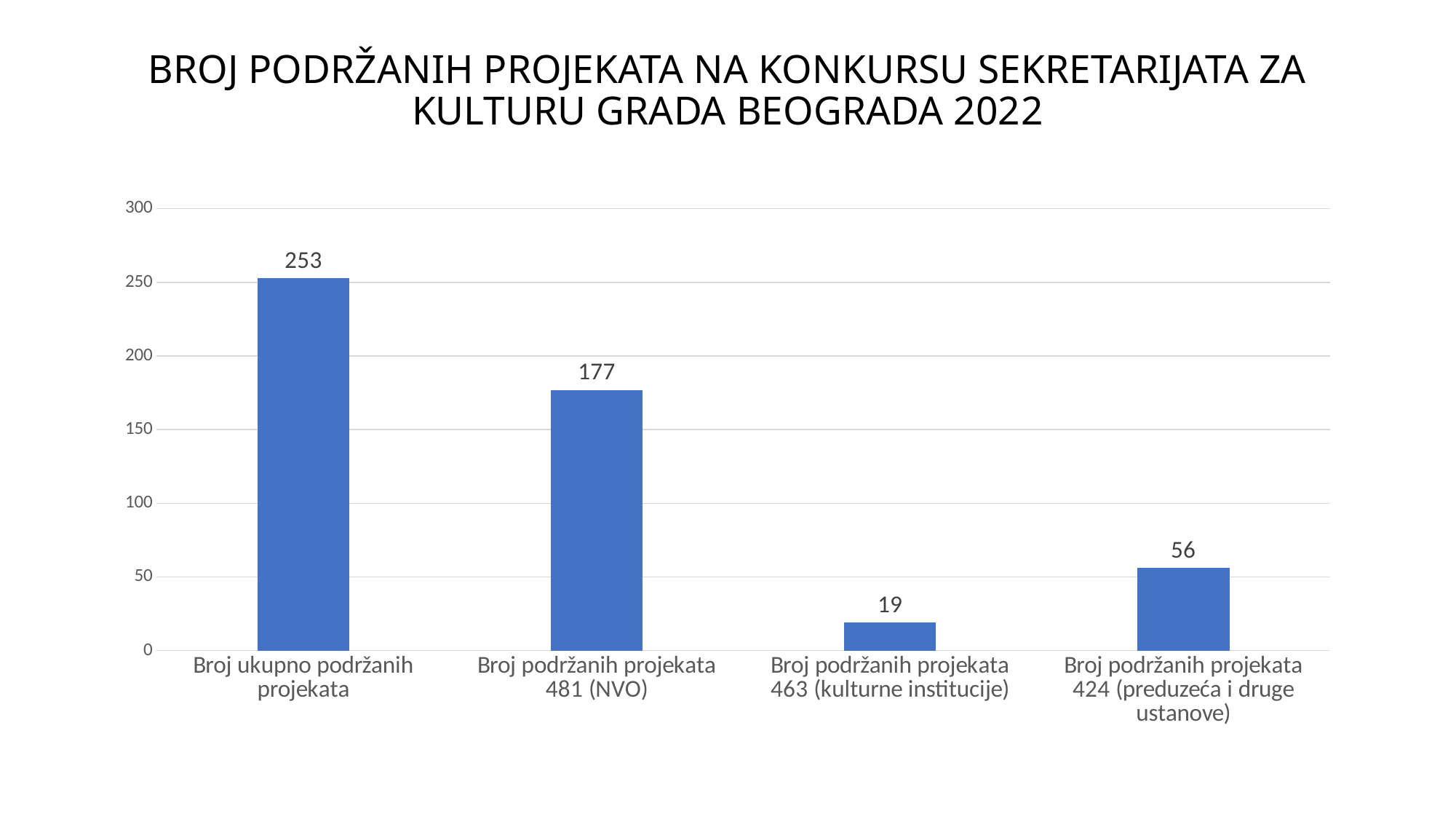
What is the value for 'Broj ukupno podržanih projekata'? 253 Which is larger: the value for 'Broj podržanih projekata 481 (NVO)' or the value for 'Broj podržanih projekata 424 (preduzeća i druge ustanove)'? Broj podržanih projekata 481 (NVO) What is the value for 'Broj podržanih projekata 463 (kulturne institucije)'? 19 What kind of chart is shown on the slide? Bar chart Which category has the lowest value? Broj podržanih projekata 463 (kulturne institucije) How many categories are shown in the chart? 4 What is the title of the chart? BROJ PODRŽANIH PROJEKATA NA KONKURSU SEKRETARIJATA ZA KULTURU GRADA BEOGRADA 2022 What is the value for 'Broj podržanih projekata 424 (preduzeća i druge ustanove)'? 56 What is the value for 'Broj podržanih projekata 481 (NVO)'? 177 What is the difference between the values for 'Broj podržanih projekata 424 (preduzeća i druge ustanove)' and 'Broj podržanih projekata 463 (kulturne institucije)'? 37 What is the difference between the values for 'Broj ukupno podržanih projekata' and 'Broj podržanih projekata 481 (NVO)'? 76 Which category has the highest value? Broj ukupno podržanih projekata